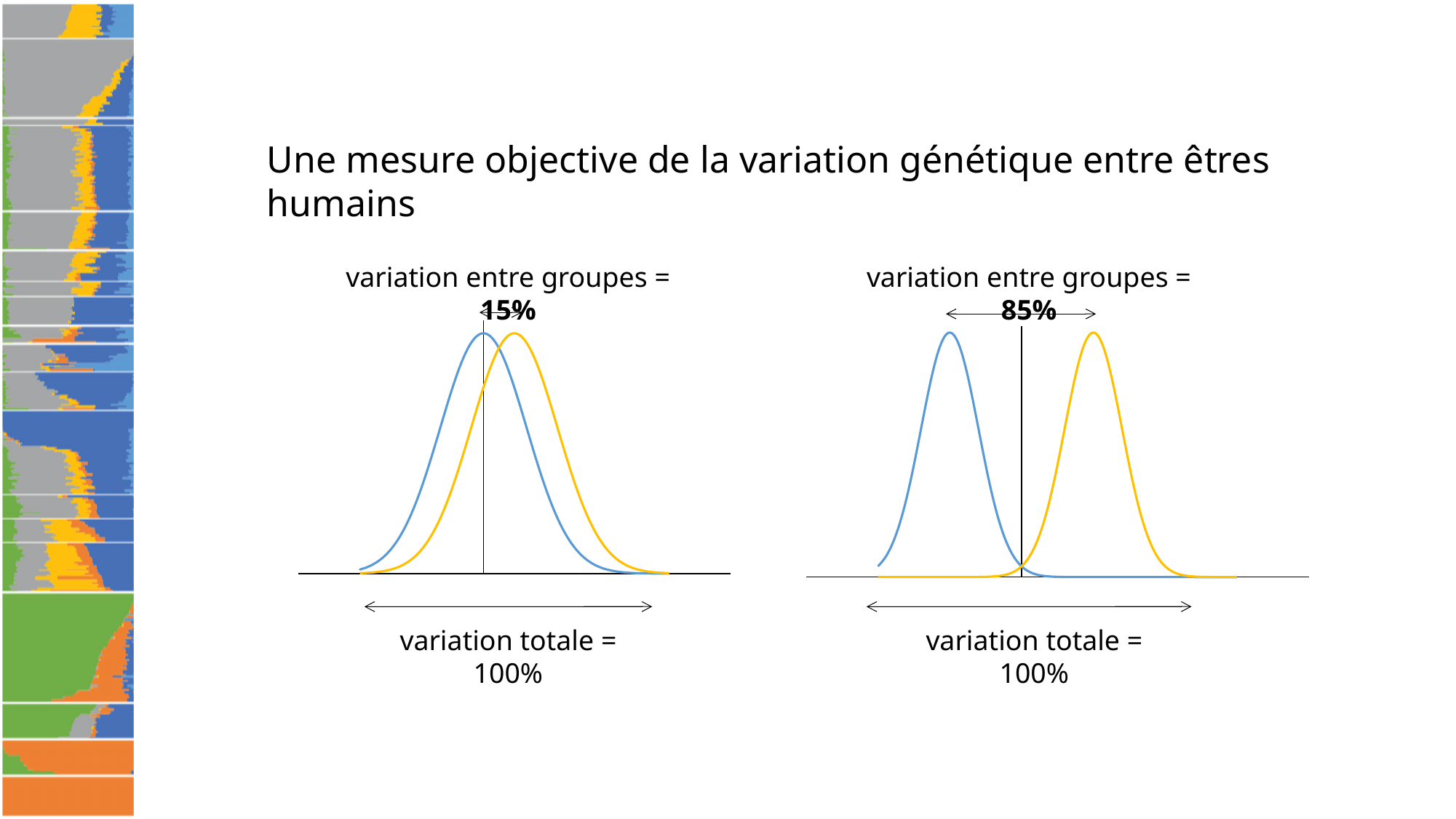
How many curves are plotted in the left chart? 2 Which chart shows the larger 'variation entre groupes', the left chart or the right chart? the right chart What colours are the two curves in the left chart? blue and yellow In the left chart, what is the value given for 'variation totale'? 100% What kind of chart is the left chart on the slide? line chart What is the difference between the 'variation entre groupes' values of the right chart and the left chart? 70% In the right chart, what is the value given for 'variation totale'? 100% How many curves are plotted in the right chart? 2 In the left chart, what is the value given for 'variation entre groupes'? 15% In the right chart, what is the value given for 'variation entre groupes'? 85% Is the 'variation entre groupes' value in the left chart greater or less than 50%? less What is the title of the slide containing the two charts? Une mesure objective de la variation génétique entre êtres humains